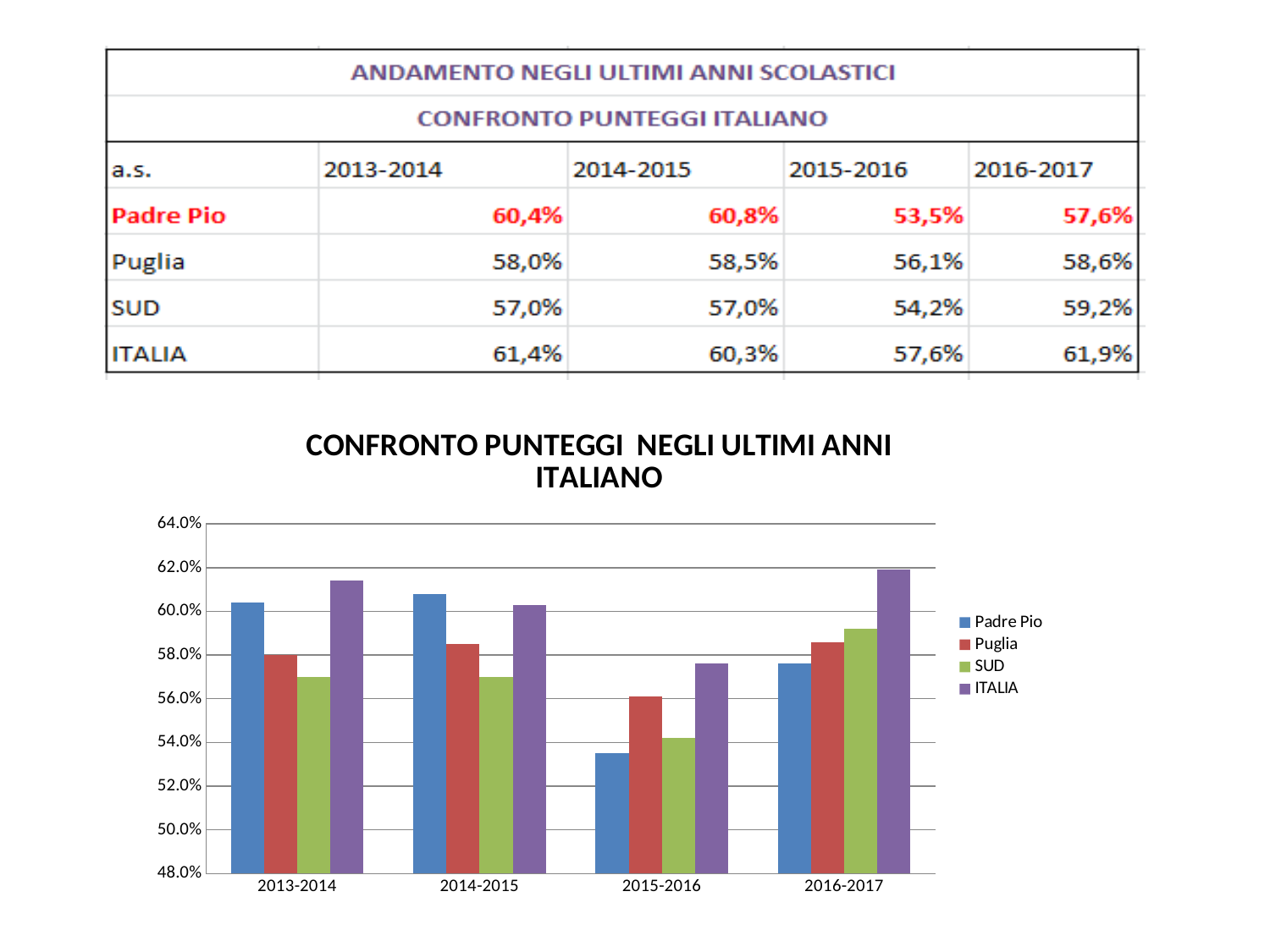
What is the value for Padre Pio in 2015-2016? 53,5% How many series does the chart legend list? 4 What is the value for ITALIA in 2016-2017? 61,9% Which series has the highest value in 2016-2017? ITALIA Which series has the lowest value in 2015-2016? Padre Pio What is the difference between ITALIA and Padre Pio in 2015-2016? 4,1% What kind of chart is shown on the slide? bar chart What is the value for SUD in 2014-2015? 57,0% How many school-year categories are shown on the x axis of the chart? 4 Which is larger in 2014-2015, Padre Pio or ITALIA? Padre Pio Which colour represents SUD in the chart legend? green Is the value for Padre Pio in 2015-2016 greater or less than 54.0%? less